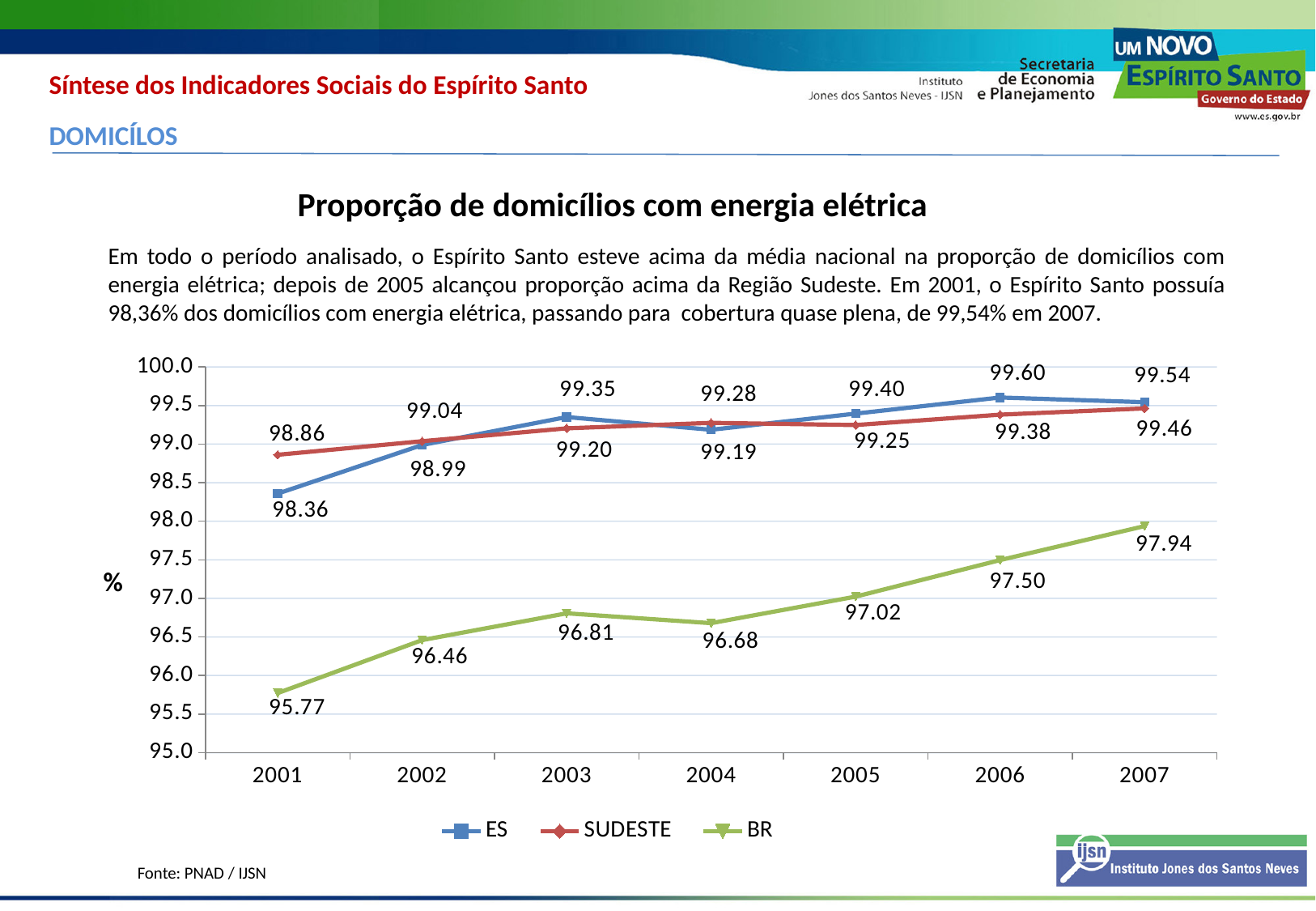
Which is larger in 2002, the ES value or the SUDESTE value? SUDESTE What is the value for BR in 2007? 97.94 In which year is the BR series at its lowest? 2001 How many series does the legend list? 3 What is the title of the chart? Proporção de domicílios com energia elétrica How many years are shown on the x axis? 7 In which year is the ES series at its highest? 2006 What is the value for SUDESTE in 2004? 99.28 Does the BR series generally rise or fall from 2001 to 2007? rise What kind of chart is shown on the slide? line chart What is the difference between the ES value and the BR value in 2007? 1.60 What is the value for ES in 2001? 98.36